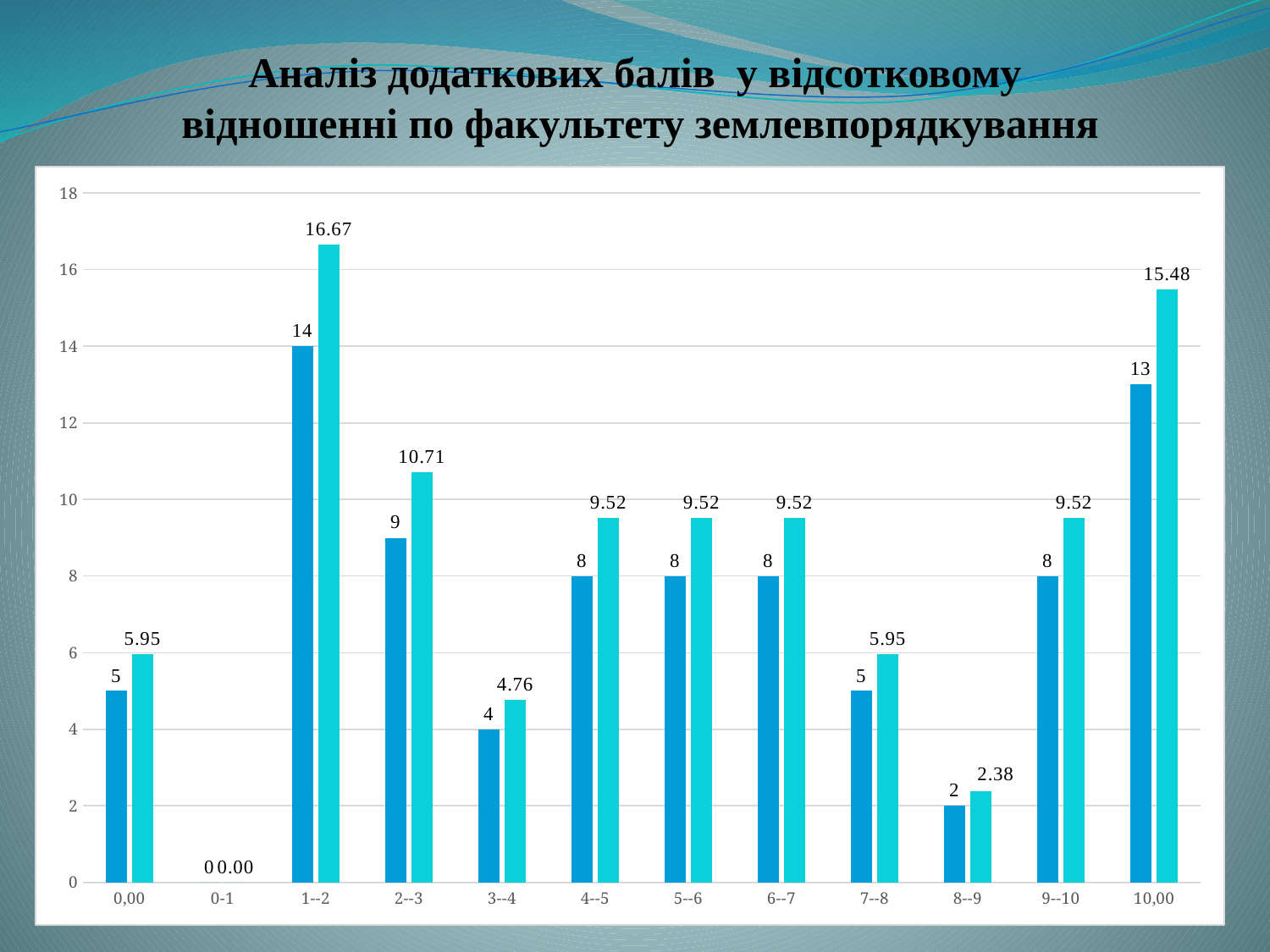
What is the value of the dark blue bar for the category 1--2? 14 How many categories are shown on the x axis? 12 What is the value of the light cyan bar for the category 2--3? 10.71 Which is larger: the light cyan bar for 2--3 or the light cyan bar for 9--10? 2--3 Which category has the lowest dark blue bar? 0-1 What is the difference between the light cyan bars for 1--2 and 3--4? 11.91 What is the value of the light cyan bar for the category 10,00? 15.48 What is the difference between the dark blue bars for 1--2 and 10,00? 1 Which category has the highest light cyan bar? 1--2 What is the title of the slide? Аналіз додаткових балів у відсотковому відношенні по факультету землевпорядкування What is the value of the dark blue bar for the category 8--9? 2 What type of chart is shown on the slide? bar chart